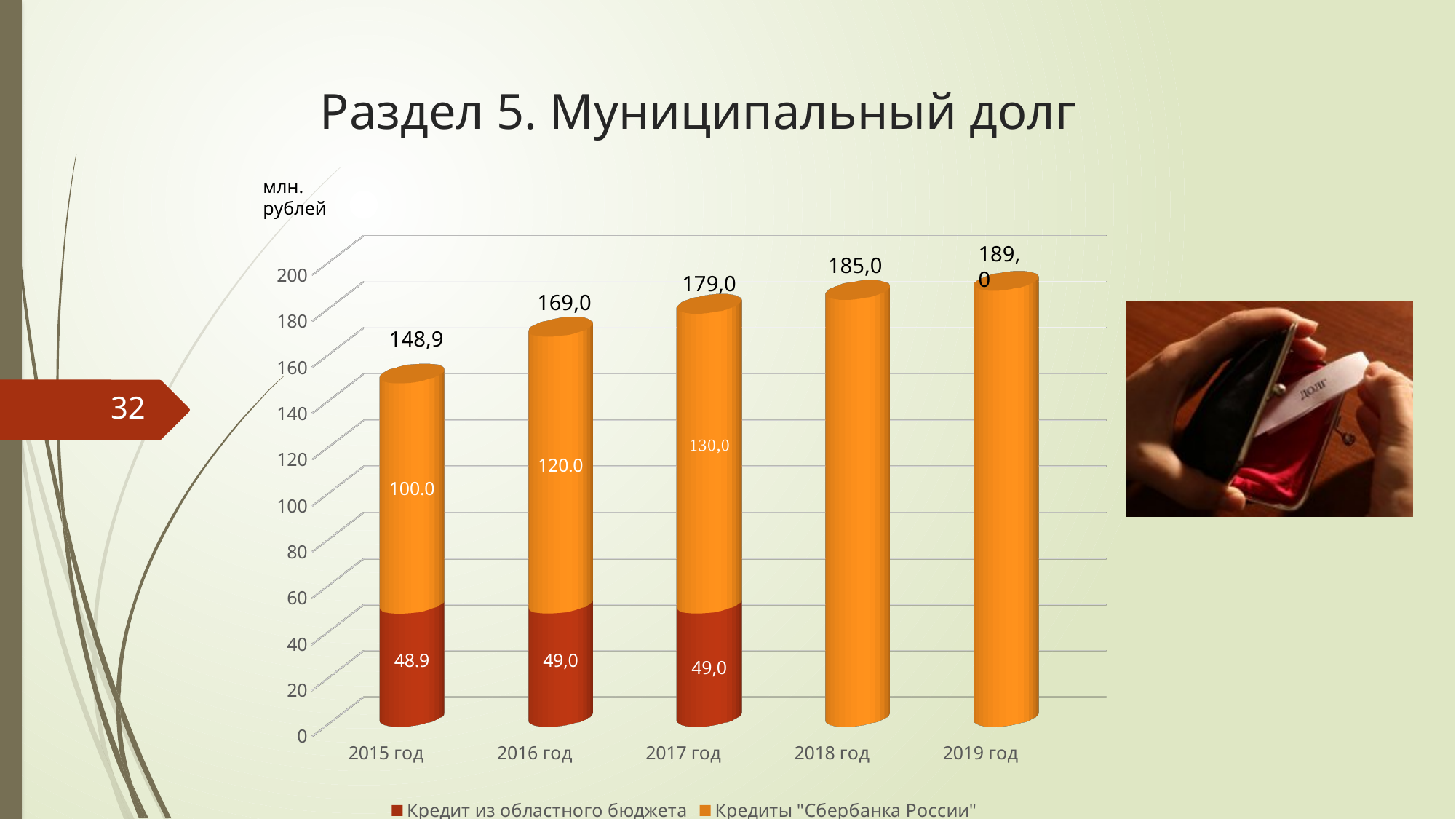
Which is larger: Кредиты "Сбербанка России" in 2017 год or in 2016 год? 2017 год How many years are shown on the x axis? 5 How many series does the legend list? 2 What is the difference between Кредиты "Сбербанка России" and Кредит из областного бюджета in 2017 год? 81,0 What is the value of Кредит из областного бюджета for 2015 год? 48.9 Do the total values rise or fall from 2015 год to 2019 год? Rise What is the value of Кредиты "Сбербанка России" for 2016 год? 120.0 By how much does the total for 2019 год exceed the total for 2015 год? 40,1 Which year has the highest total municipal debt? 2019 год Which year has the lowest total municipal debt? 2015 год What kind of chart is shown on the slide? Stacked bar chart What is the total municipal debt shown for 2018 год? 185,0